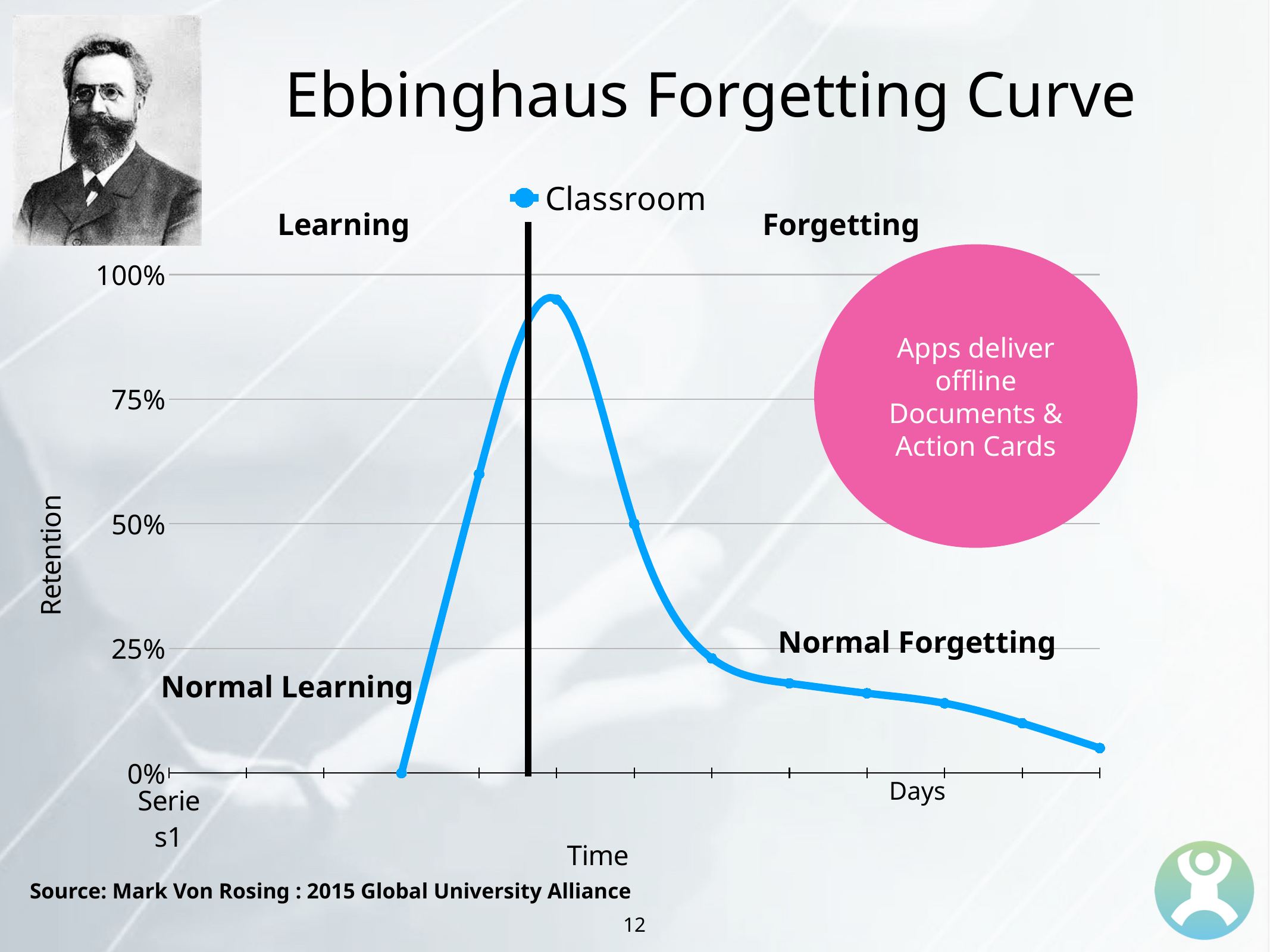
Which is larger: the retention value at the peak of the curve or the retention value of the last plotted point? the peak What is the retention value of the first plotted point of the Classroom series? 0% How many series does the chart legend list? 1 Is the peak retention value of the Classroom series greater or less than 75%? greater Do the retention values rise or fall along the x axis after the peak of the curve? fall What is the name of the series shown in the chart legend? Classroom Do the retention values rise or fall along the x axis in the Learning section before the Classroom line? rise What kind of chart is shown on the slide? line chart Is the retention value of the last plotted point of the Classroom series greater or less than 25%? less How many data points are plotted on the Classroom series? 10 What is the label of the vertical axis of the chart? Retention Is the retention value of the second plotted point (just before the Classroom line) greater or less than 50%? greater